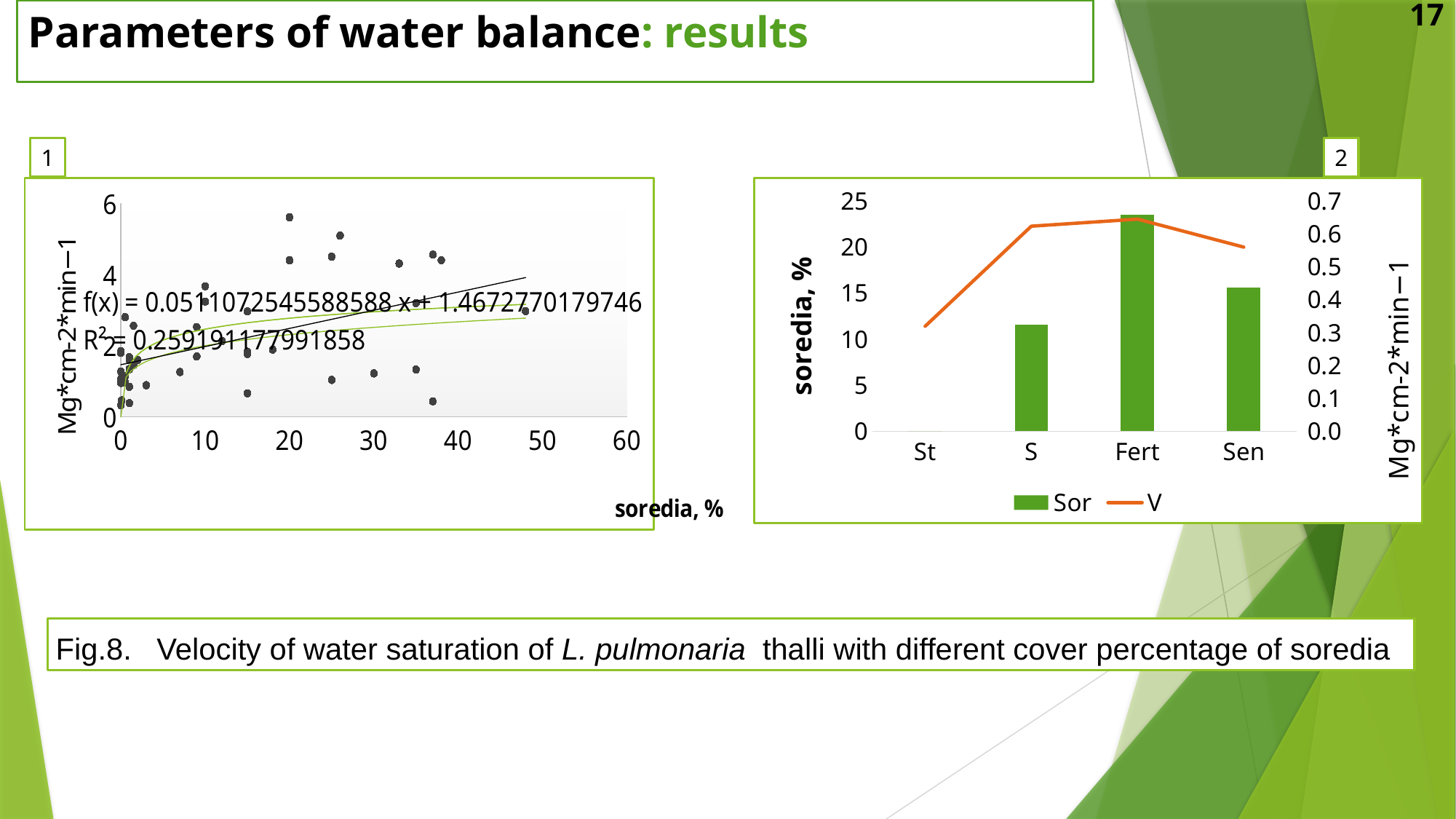
What are the two legend entries of chart 2 on the right? Sor and V In chart 2 on the right, is the Sor value for S greater or less than 15? less How many categories are shown on the x axis of chart 2 on the right? 4 In chart 2 on the right, which has the taller Sor bar, S or Sen? Sen In chart 2 on the right, is the Sor value for Fert greater or less than 20? greater What kind of chart is chart 1 on the left of the slide? scatter chart How many series does the legend of chart 2 on the right list? 2 In chart 2 on the right, is the V value for St greater or less than 0.5? less In chart 2 on the right, which category has the tallest Sor bar? Fert What R² value is printed on chart 1 on the left? 0.259191177991858 In chart 2 on the right, does the V line rise or fall from Fert to Sen? fall In chart 2 on the right, what kind of chart is used for the Sor series? bar chart